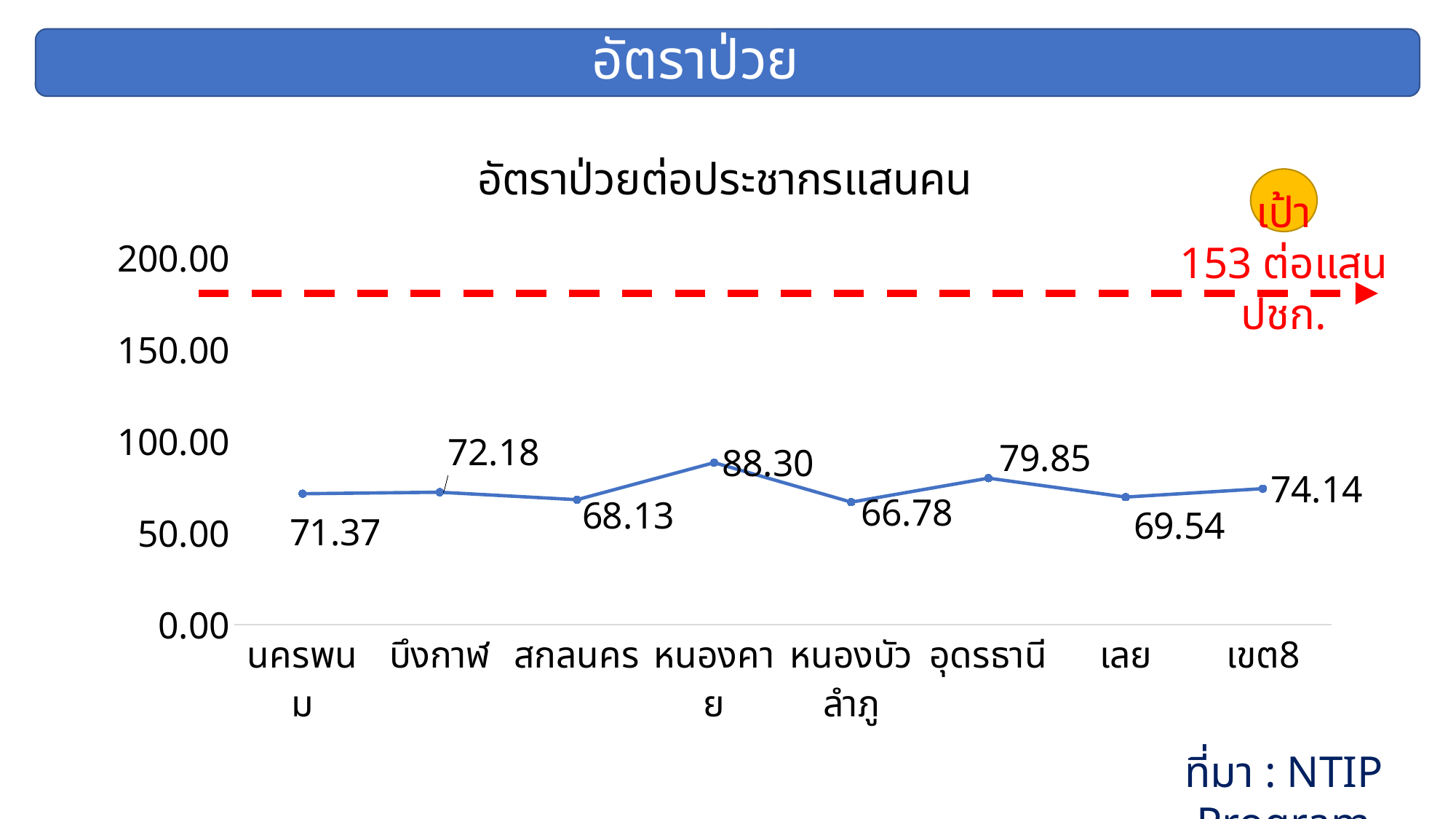
Which category has the highest value? หนองคาย What is the title of the chart? อัตราป่วยต่อประชากรแสนคน What target value is indicated by the red dashed line? 153 ต่อแสน ปชก. What is the value for หนองคาย? 88.30 Which category has the lowest value? หนองบัวลำภู What is the value for เขต8? 74.14 What is the difference between the values for หนองคาย and หนองบัวลำภู? 21.52 Which is larger, the value for อุดรธานี or the value for เลย? อุดรธานี What is the value for อุดรธานี? 79.85 How many categories are shown on the x axis? 8 Is the value for สกลนคร greater or less than 100.00? less What kind of chart is shown on the slide? line chart